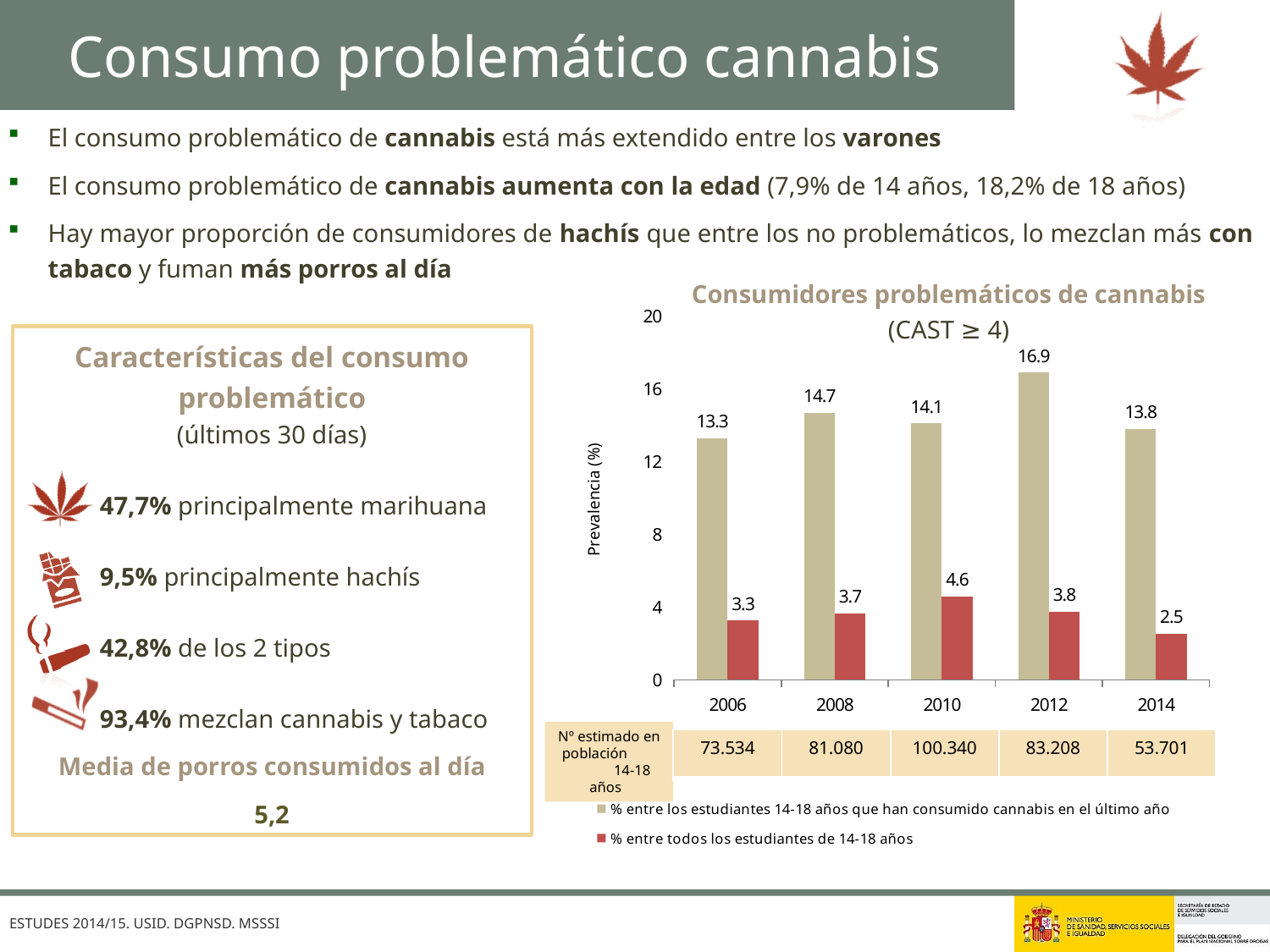
Which year has the lowest value in the series '% entre todos los estudiantes de 14-18 años'? 2014 What is the value for 2012 in the series '% entre los estudiantes 14-18 años que han consumido cannabis en el último año'? 16.9 Does the series '% entre todos los estudiantes de 14-18 años' rise or fall from 2012 to 2014? fall What is the title of the chart? Consumidores problemáticos de cannabis (CAST ≥ 4) How many series does the chart legend list? 2 What is the difference between the 2012 and 2014 values in the series '% entre los estudiantes 14-18 años que han consumido cannabis en el último año'? 3.1 Which year has the highest value in the series '% entre los estudiantes 14-18 años que han consumido cannabis en el último año'? 2012 What is the value for 2010 in the series '% entre todos los estudiantes de 14-18 años'? 4.6 In the series '% entre todos los estudiantes de 14-18 años', which is larger: the value for 2008 or the value for 2012? 2012 How many years are shown on the x axis of the chart? 5 What type of chart is shown on the slide? bar chart Is the value for 2006 in the series '% entre los estudiantes 14-18 años que han consumido cannabis en el último año' greater or less than 12? greater